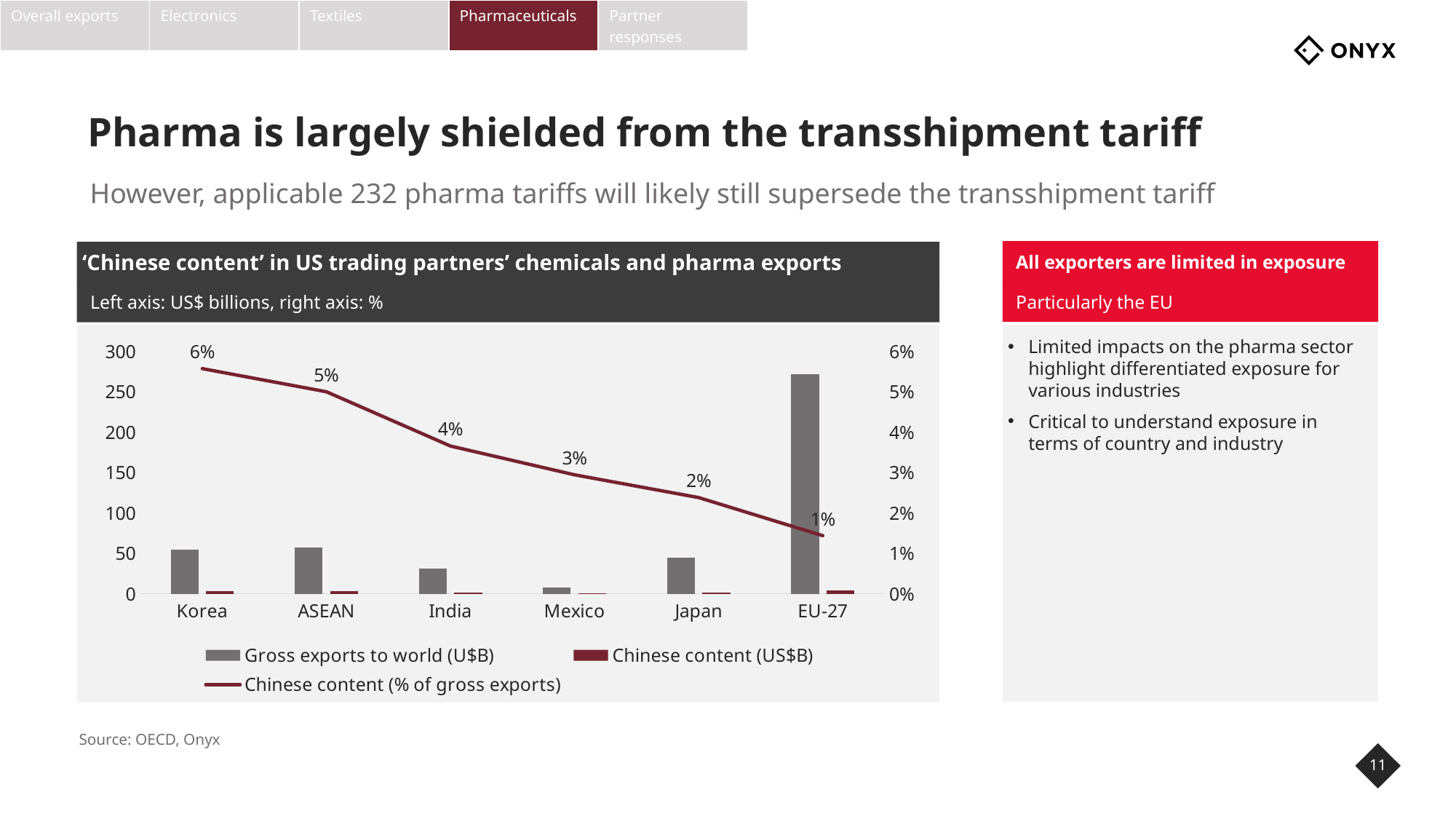
Which has larger gross exports to world, Japan or India? Japan What is the Chinese content (% of gross exports) for EU-27? 1% Is the value of gross exports to world for Korea greater or less than 100? less Which trading partner has the highest gross exports to world? EU-27 How many series does the legend list? 3 How many trading partners are shown on the x axis? 6 How does the Chinese content (% of gross exports) change moving from Korea to EU-27 along the x axis? It falls Is the value of gross exports to world for EU-27 greater or less than 250? greater What is the difference between the Chinese content percentage for Korea and for EU-27? 5 percentage points What is the Chinese content (% of gross exports) for India? 4% What is the Chinese content (% of gross exports) for Korea? 6% Which trading partner has the lowest gross exports to world? Mexico